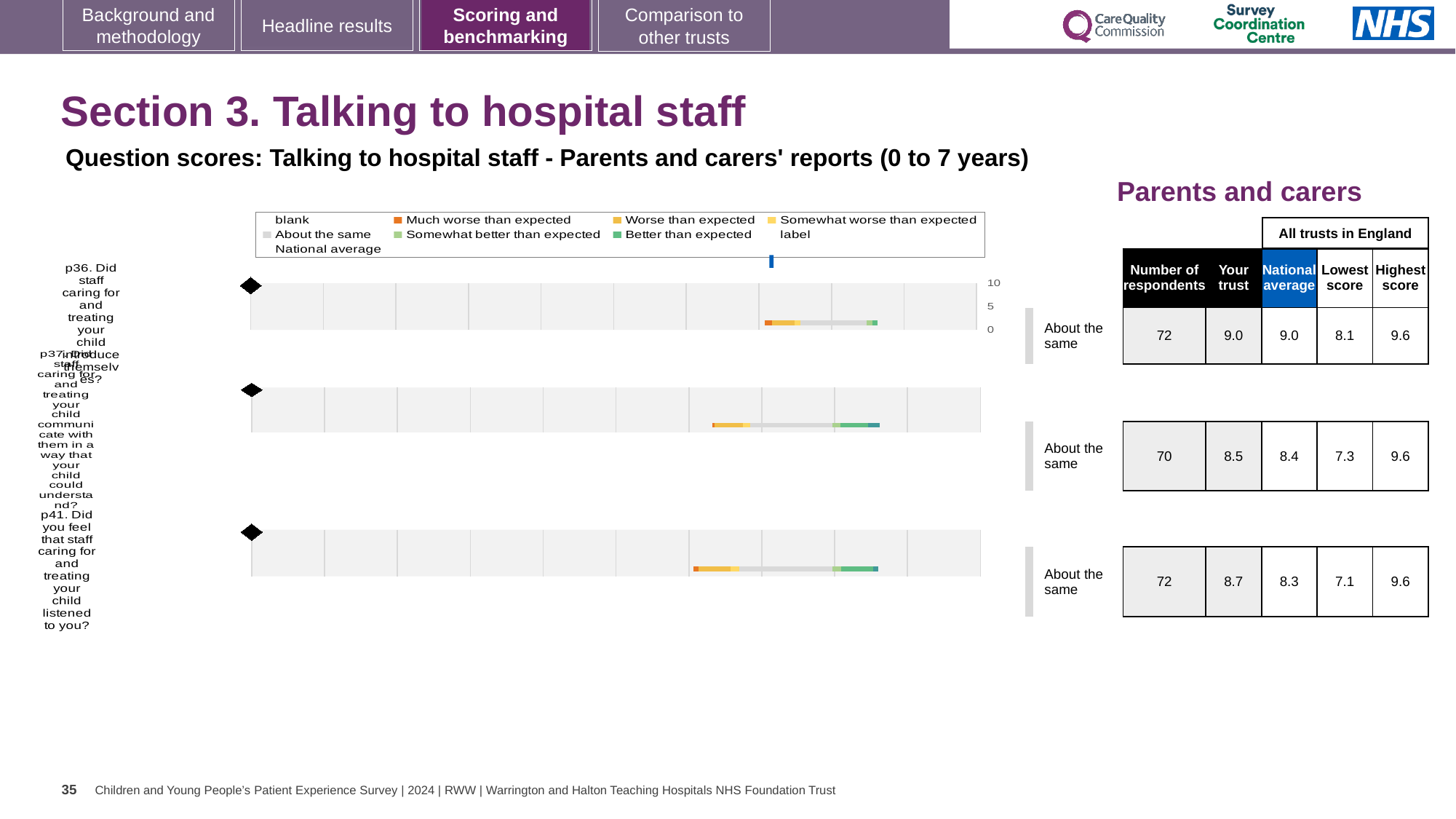
What is the difference between the 'Your trust' score and the national average for p41? 0.4 What is the national average score for p37 (Did staff communicate with your child in a way they could understand?)? 8.4 What is the highest score across all trusts in England for p37? 9.6 What benchmark category is shown next to each of the three questions? About the same How many respondents answered p41 (Did you feel that staff listened to you?)? 72 Which question has the highest 'Your trust' score? p36 What is the 'Your trust' score for p36 (Did staff caring for and treating your child introduce themselves?)? 9.0 Which question has the lowest 'Lowest score' across all trusts in England? p41 What kind of chart is used to show the question scores? Bar chart What is the lowest score across all trusts in England for p36? 8.1 Which has the larger 'Your trust' score, p37 or p41? p41 How many questions are plotted on this slide? 3